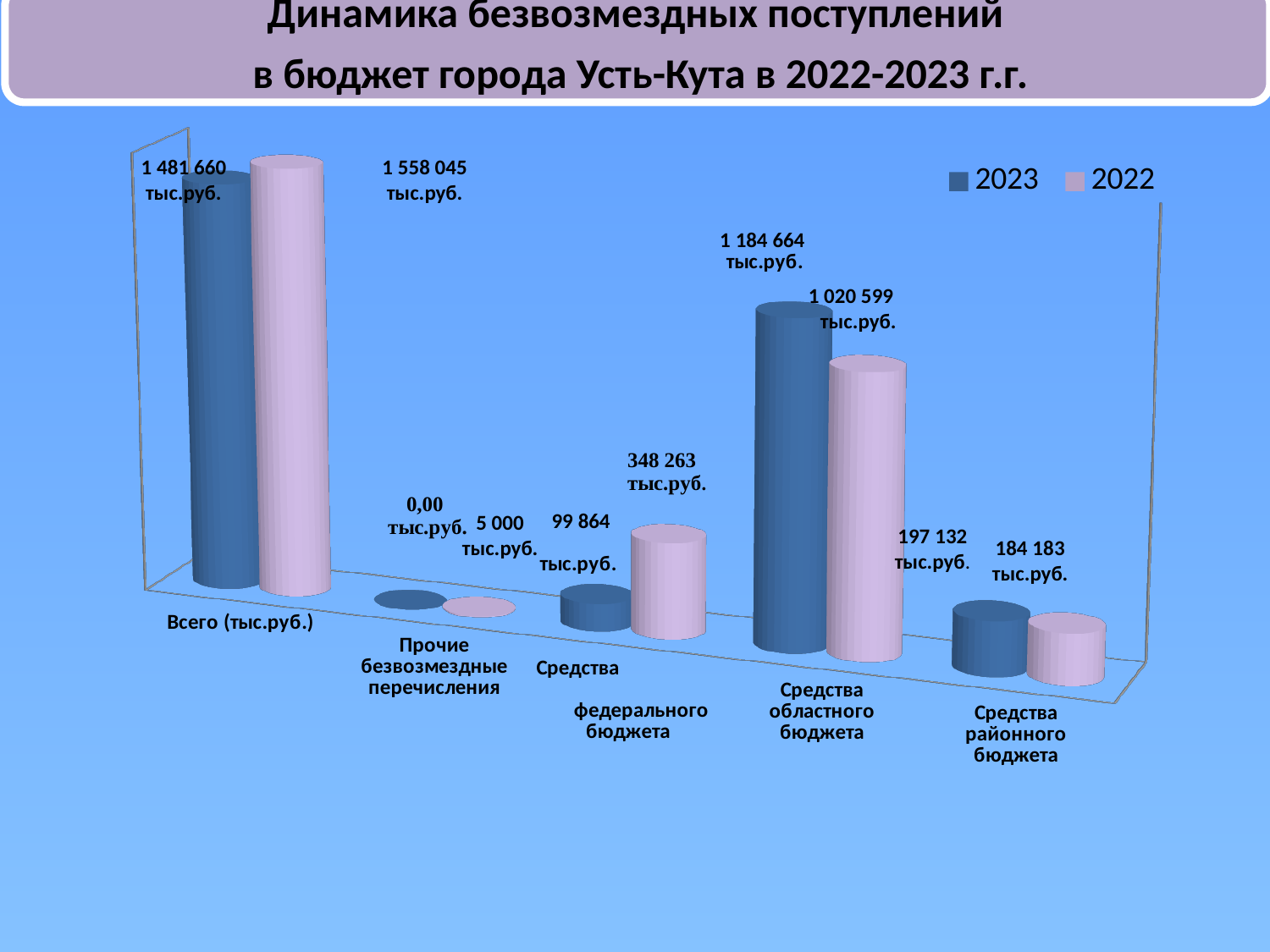
What is the value for 2023 in the category Всего (тыс.руб.)? 1 481 660 тыс.руб. What is the value for 2022 in the category Прочие безвозмездные перечисления? 5 000 тыс.руб. How many series does the legend list? 2 For Всего (тыс.руб.), which year has the larger value, 2023 or 2022? 2022 What is the value for 2023 in the category Средства областного бюджета? 1 184 664 тыс.руб. What is the difference between the 2022 and 2023 values for Средства федерального бюджета? 248 399 тыс.руб. What is the value for 2023 in the category Средства районного бюджета? 197 132 тыс.руб. Which category has the lowest value for 2023? Прочие безвозмездные перечисления What is the difference between the 2023 and 2022 values for Средства областного бюджета? 164 065 тыс.руб. What is the value for 2022 in the category Средства федерального бюджета? 348 263 тыс.руб. What kind of chart is shown on the slide? Bar chart Excluding the Всего total, which category has the highest value for 2022? Средства областного бюджета